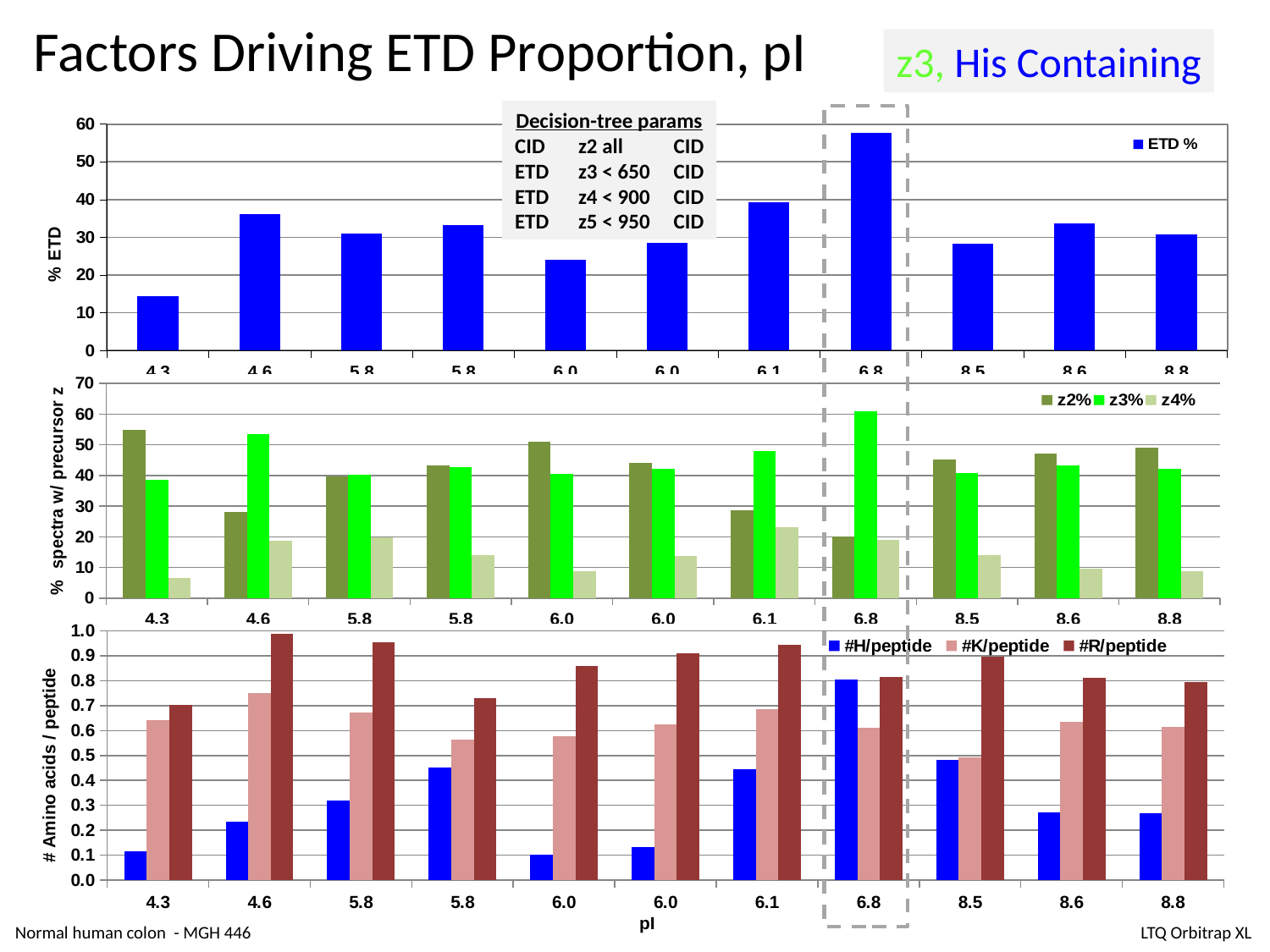
In the bottom chart (# Amino acids / peptide), which series does the legend list first? #H/peptide In the top chart (% ETD), which pI category has the lowest bar? 4.3 In the bottom chart (# Amino acids / peptide), is the #R/peptide value for pI 4.6 greater or less than 0.9? greater In the top chart (% ETD), how many pI categories are plotted along the x axis? 11 In the bottom chart (# Amino acids / peptide), which pI category has the highest #H/peptide bar? 6.8 In the top chart (% ETD), is the value for pI 4.3 greater or less than 20? less In the middle chart (% spectra w/ precursor z), is the z3% value for pI 6.8 greater or less than 50? greater In the middle chart (% spectra w/ precursor z), at pI 6.8, which is larger: z2% or z3%? z3% What kind of chart is the top chart (% ETD)? bar chart In the middle chart (% spectra w/ precursor z), how many series does the legend list? 3 In the top chart (% ETD), which pI category has the highest bar? 6.8